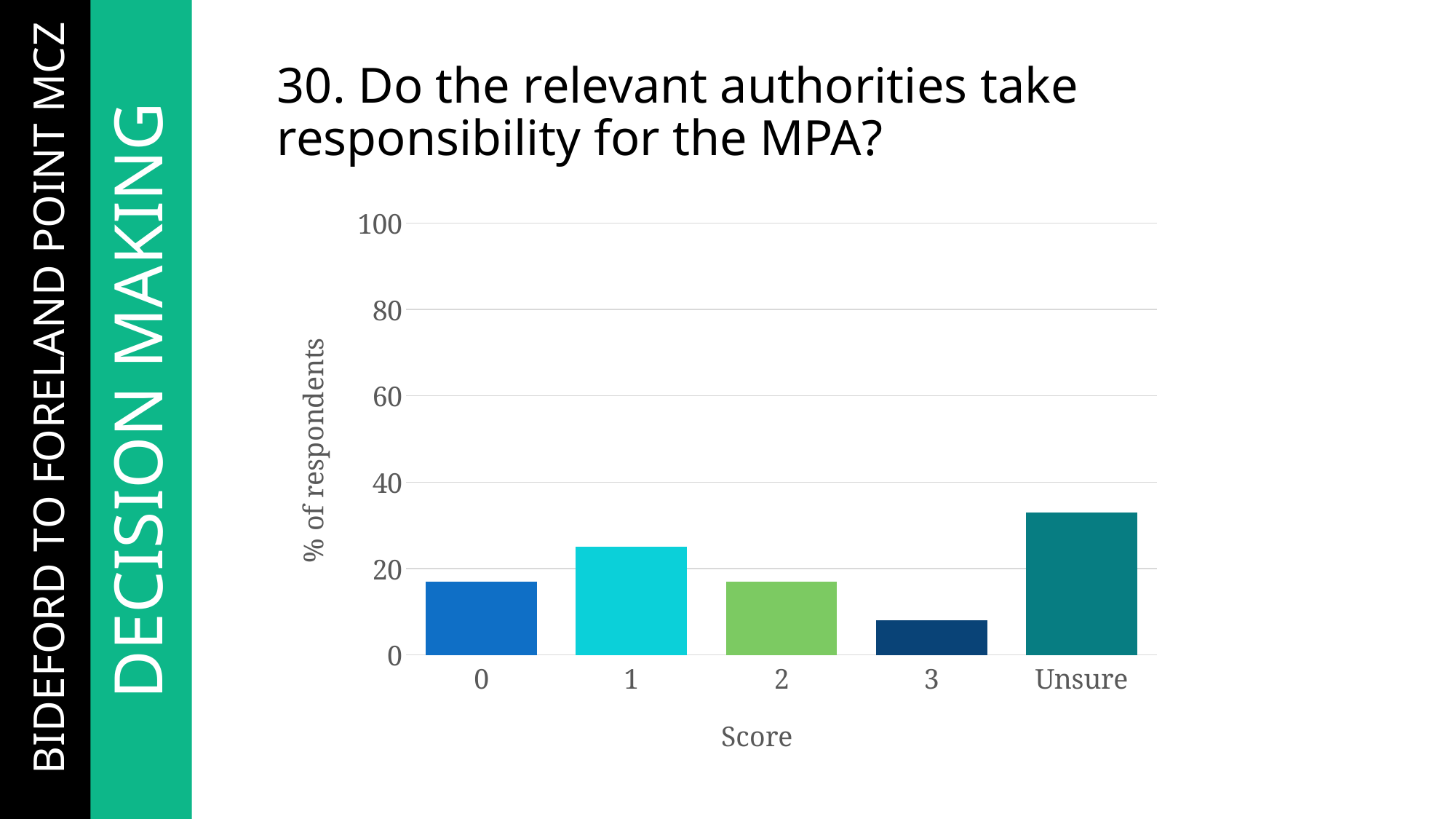
What is the label of the x axis? Score What is the label of the y axis? % of respondents Which has a higher percentage of respondents, score 1 or score 0? 1 Is the value for score 1 greater or less than 20? greater What kind of chart is shown on the slide? bar chart Is the value for Unsure greater or less than 40? less Which score category has the lowest percentage of respondents? 3 Is the value for score 0 greater or less than 20? less How many score categories are shown on the x axis? 5 Which has a higher percentage of respondents, Unsure or score 3? Unsure Which score category has the highest percentage of respondents? Unsure